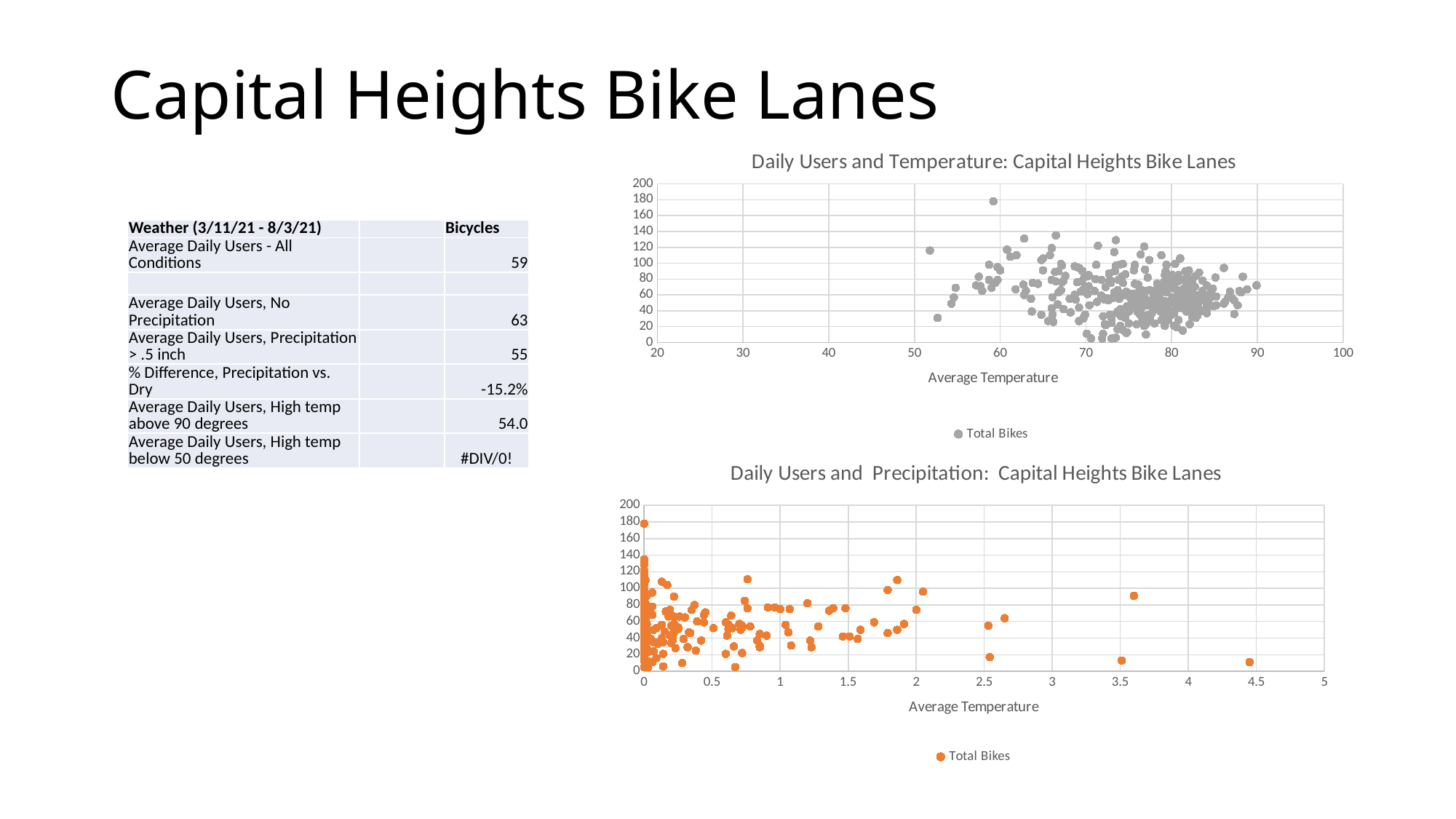
What kind of chart is the top chart, 'Daily Users and Temperature: Capital Heights Bike Lanes'? scatter chart In the top chart, is the value of the highest point greater or less than 160? greater In the bottom chart, how many series does the legend list? 1 What is the title of the bottom chart? Daily Users and Precipitation: Capital Heights Bike Lanes In the bottom chart, is the value of the highest point greater or less than 160? greater In the bottom chart, is the value of the point at about 3.6 on the x axis greater or less than 60? greater What kind of chart is the bottom chart, 'Daily Users and Precipitation: Capital Heights Bike Lanes'? scatter chart In the top chart, how many series does the legend list? 1 What is the name of the series shown in the legend of the top chart? Total Bikes